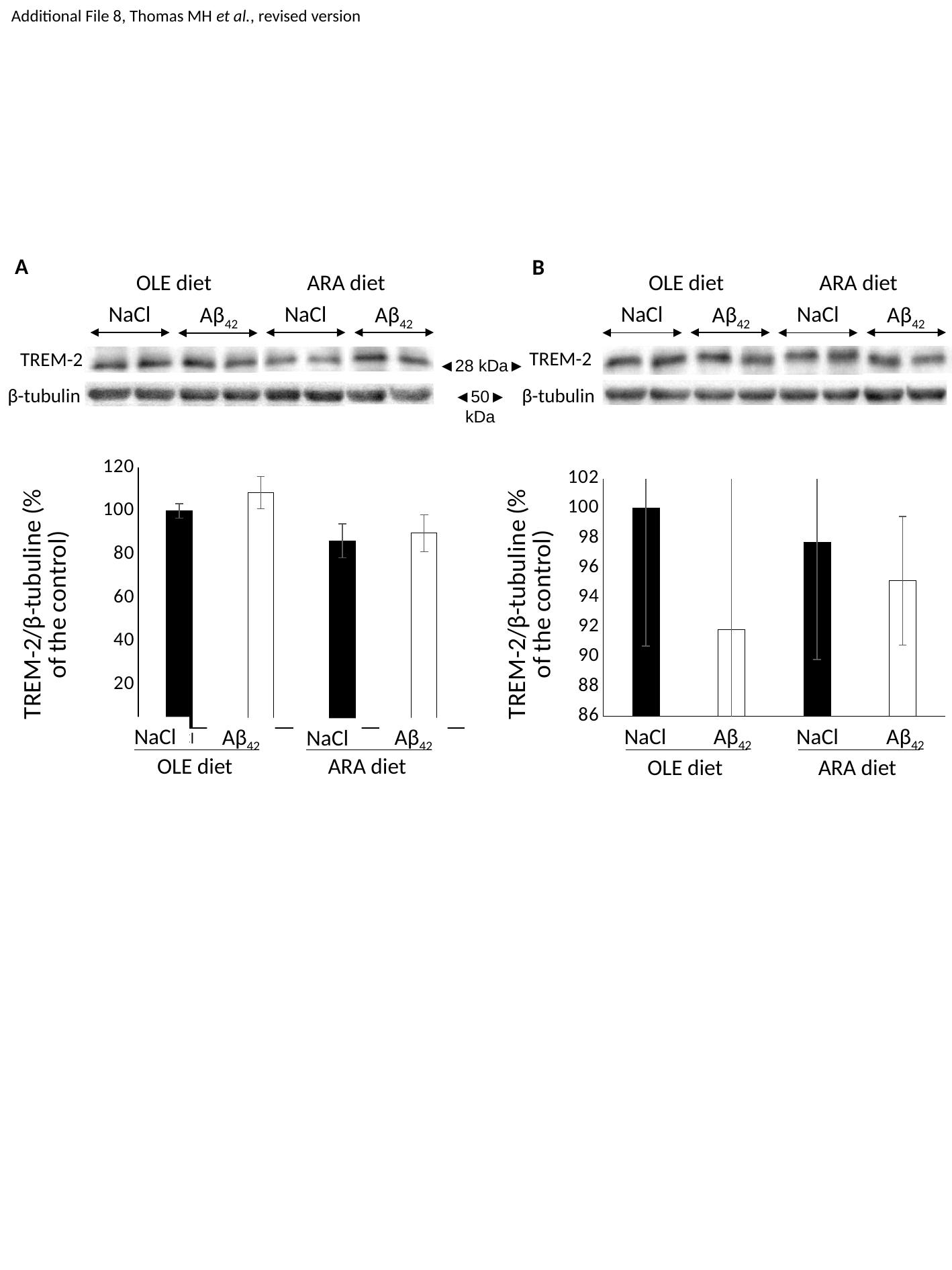
In chart B (the right chart), is the value for Aβ42 under the OLE diet greater or less than 94? less In chart B (the right chart), which bar is the highest? NaCl, OLE diet In chart A (the left chart), is the value for NaCl under the ARA diet greater or less than 100? less In chart A (the left chart), how many bars are plotted? 4 In chart A (the left chart), which is larger: the NaCl bar under the OLE diet or the NaCl bar under the ARA diet? NaCl, OLE diet In chart A (the left chart), what colour are the NaCl bars? black What is the y-axis label of chart B (the right chart)? TREM-2/β-tubuline (% of the control) What kind of chart is chart A (the left chart)? bar chart In chart B (the right chart), which bar is the lowest? Aβ42, OLE diet In chart B (the right chart), is the value for NaCl under the ARA diet greater or less than 96? greater In chart A (the left chart), which bar is the highest? Aβ42, OLE diet